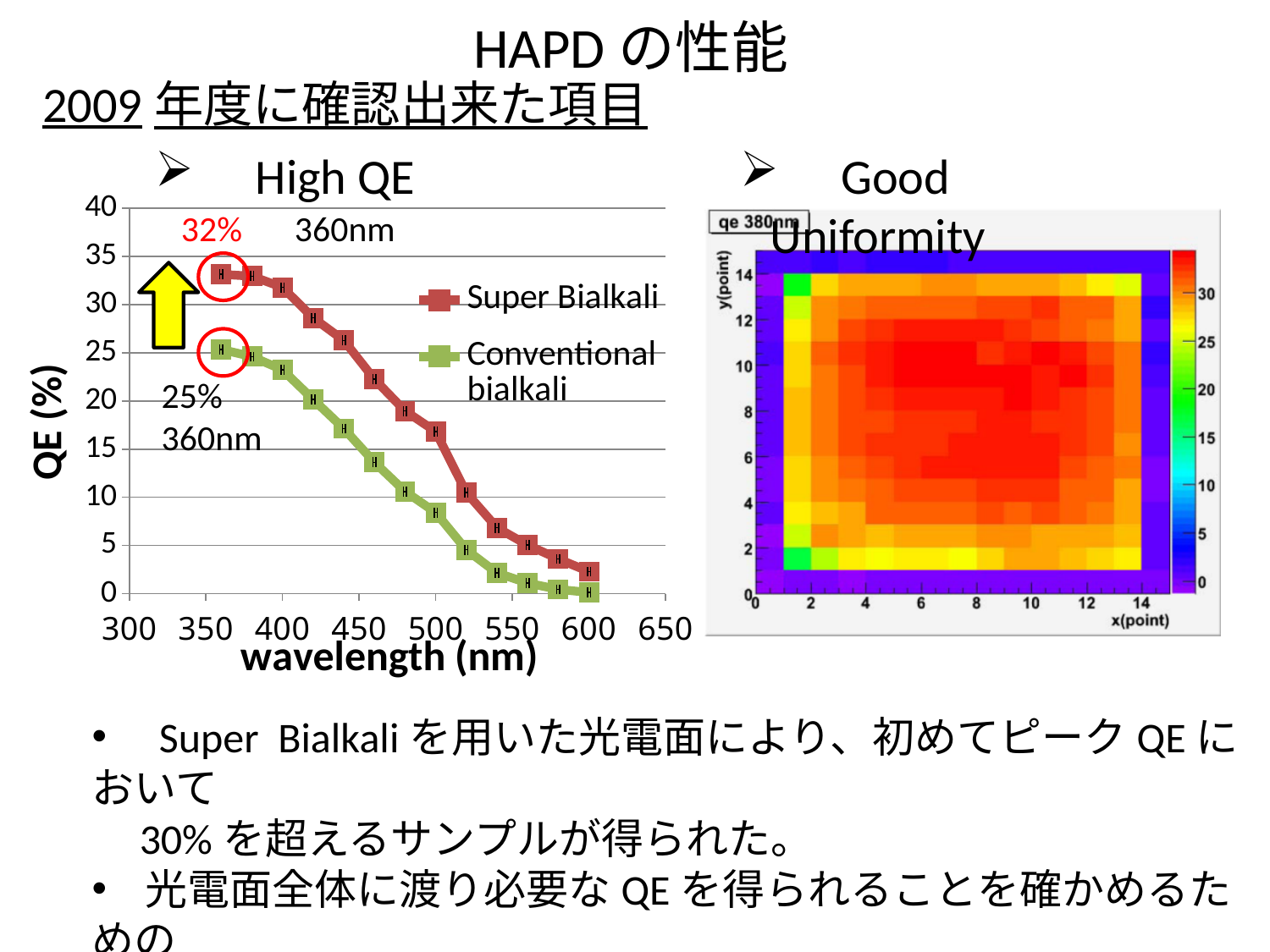
In the High QE chart, is the Conventional bialkali value at 500nm greater or less than 10? less In the High QE chart, is the Super Bialkali value at 500nm greater or less than 15? greater What kind of chart is the High QE chart on the left? Line chart In the High QE chart, which series has the higher QE at 360nm, Super Bialkali or Conventional bialkali? Super Bialkali In the High QE chart, does QE rise or fall as wavelength increases from 360nm to 600nm? Fall How many series does the legend of the High QE chart list? 2 What is the title shown in the box at the top left of the Good Uniformity heatmap on the right? qe 380nm What is the x-axis label of the High QE chart? wavelength (nm) In the High QE chart, what is the QE of Super Bialkali at 360nm? 32% In the High QE chart, is the Super Bialkali value at 600nm greater or less than 5? less In the High QE chart, what is the QE of Conventional bialkali at 360nm? 25% In the High QE chart, what is the difference between the Super Bialkali and Conventional bialkali QE values at 360nm? 7%